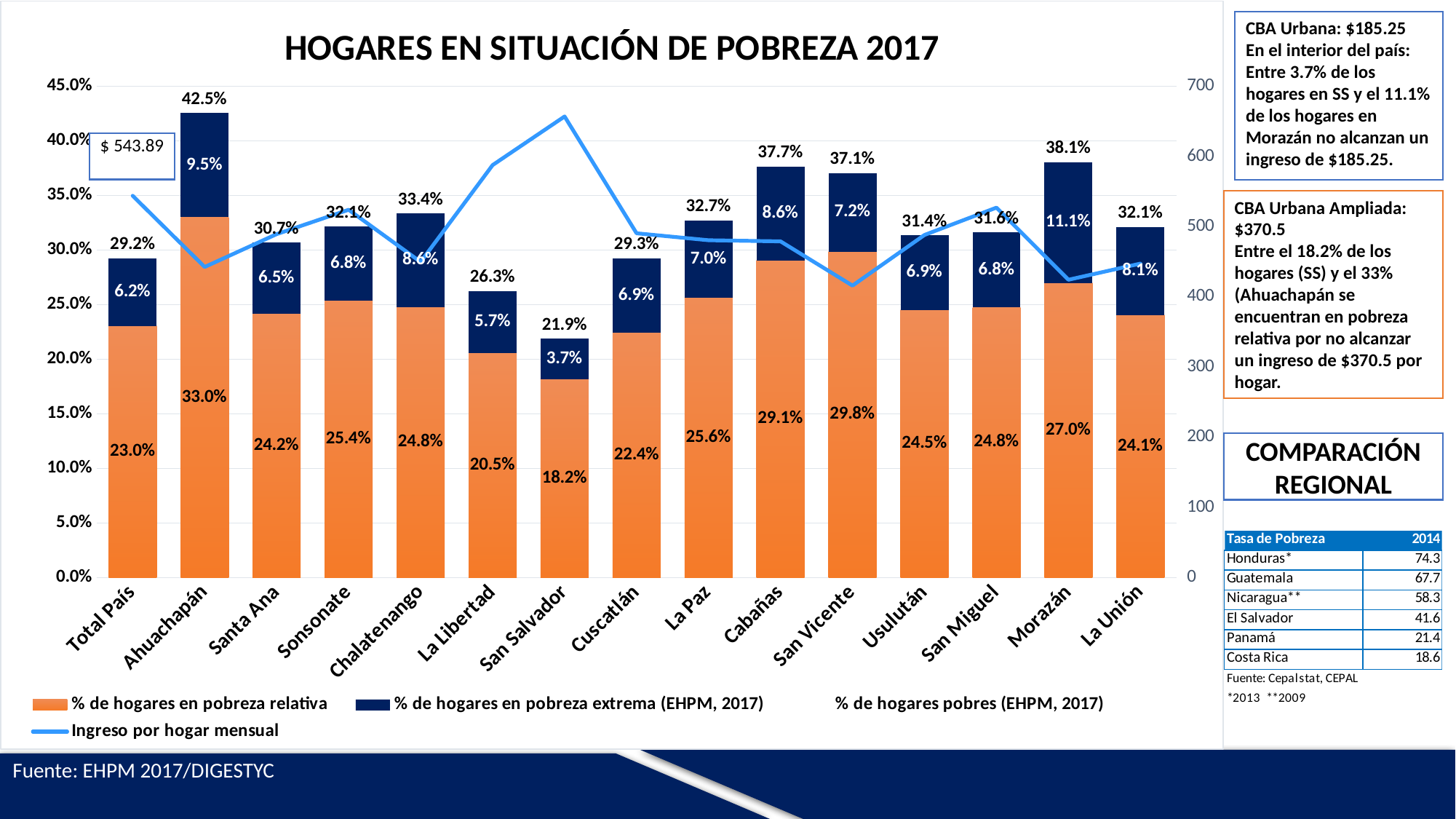
What is the value of '% de hogares en pobreza extrema' for Morazán? 11.1% What is the difference between the '% de hogares pobres' totals for Ahuachapán and San Salvador? 20.6 percentage points Is the 'Ingreso por hogar mensual' value for San Salvador greater or less than 600? greater What is the value of '% de hogares en pobreza relativa' for San Salvador? 18.2% Which has a higher '% de hogares pobres' total, Cabañas or San Vicente? Cabañas What is the 'Ingreso por hogar mensual' value labelled for Total País? $ 543.89 Which category has the lowest '% de hogares pobres' total? San Salvador What is the title of the chart? HOGARES EN SITUACIÓN DE POBREZA 2017 What kind of chart is shown on the slide? Stacked bar chart with a line How many categories are shown on the x axis of the chart? 15 Which category has the highest '% de hogares pobres' total? Ahuachapán How many series does the chart legend list? 4